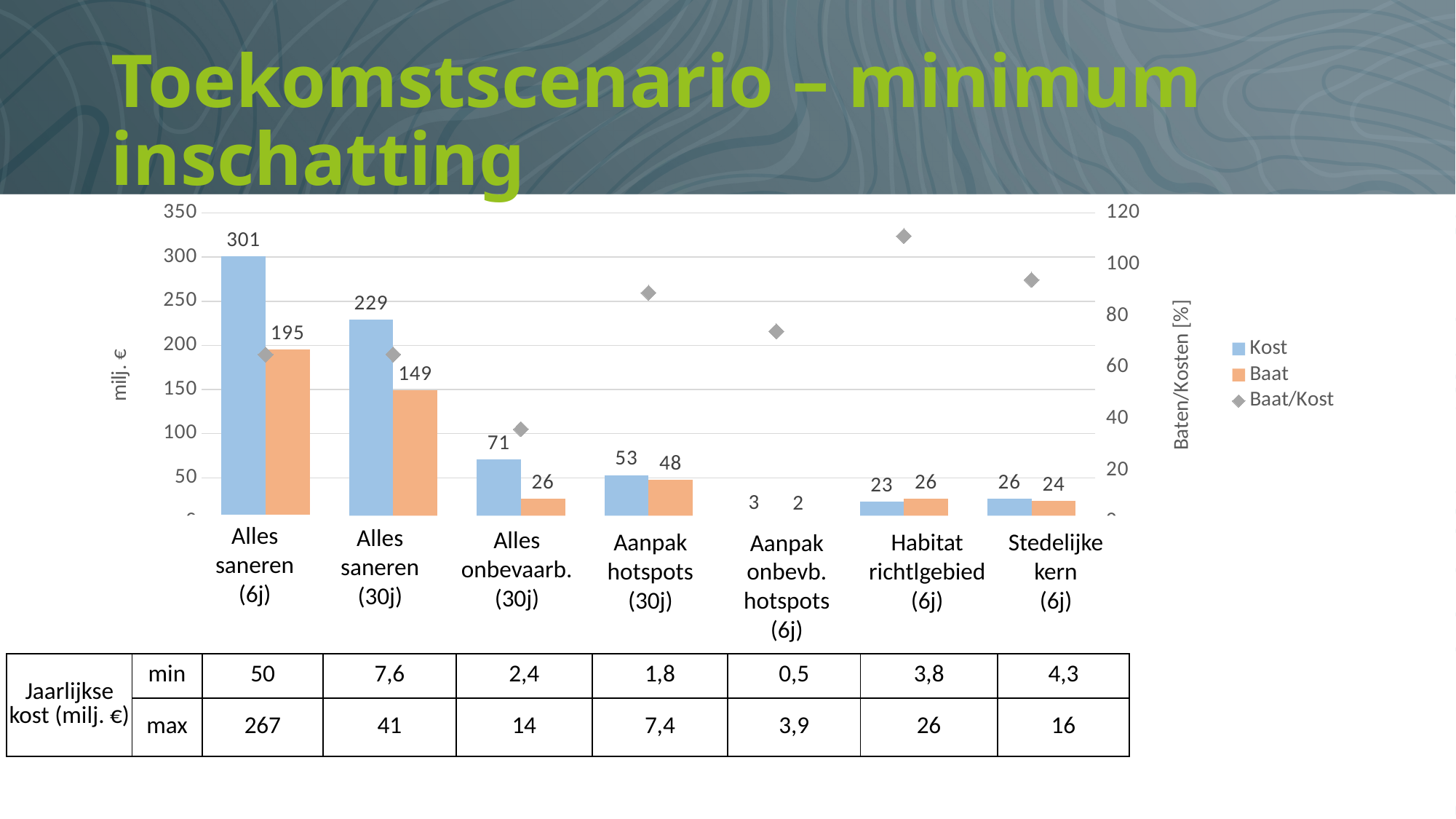
What is the Kost value for Alles saneren (6j)? 301 What is the difference between Kost and Baat for Alles saneren (6j)? 106 Is the Baat/Kost value for Habitat richtlgebied (6j) greater or less than 100? greater What is the difference between Kost and Baat for Alles saneren (30j)? 80 Which category has the lowest Baat value? Aanpak onbevb. hotspots (6j) What is the Kost value for Aanpak hotspots (30j)? 53 For Habitat richtlgebied (6j), which is larger, Kost or Baat? Baat Which series is plotted as diamond markers rather than bars? Baat/Kost How many series does the legend list? 3 Which category has the highest Kost value? Alles saneren (6j) How many categories are shown on the x axis? 7 What is the Baat value for Alles saneren (30j)? 149